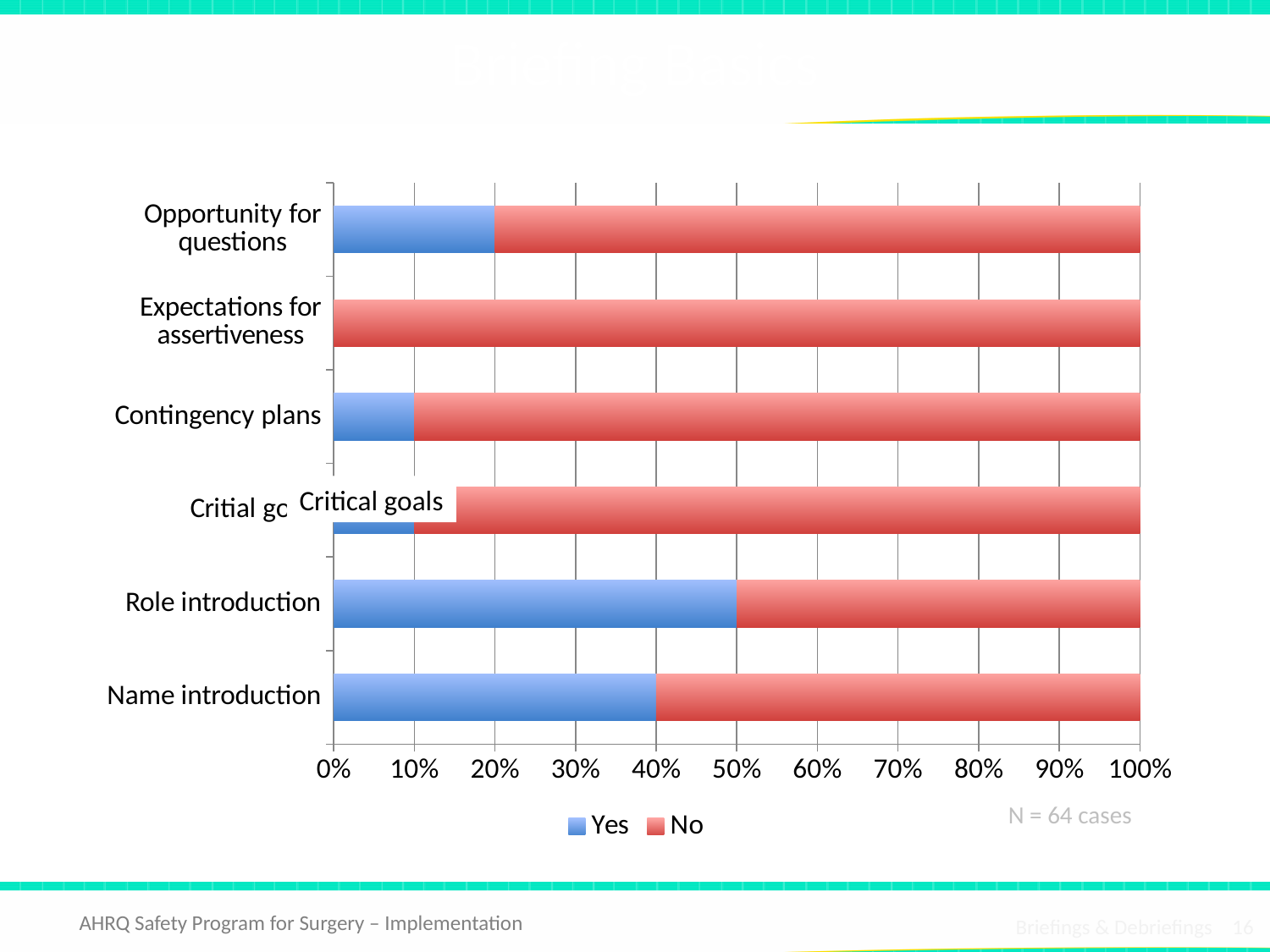
What is the Yes value for Contingency plans? 10% What is the Yes value for Name introduction? 40% What kind of chart is shown on the slide? Stacked bar chart How many categories are shown on the chart? 6 Which category has the highest Yes share? Role introduction What is the Yes value for Role introduction? 50% Which category has the lowest Yes share? Expectations for assertiveness What is the difference between the Yes values for Role introduction and Name introduction? 10% What is the Yes value for Opportunity for questions? 20% What sample size is noted below the chart? N = 64 cases Which has a larger Yes share, Opportunity for questions or Contingency plans? Opportunity for questions How many series does the legend list? 2